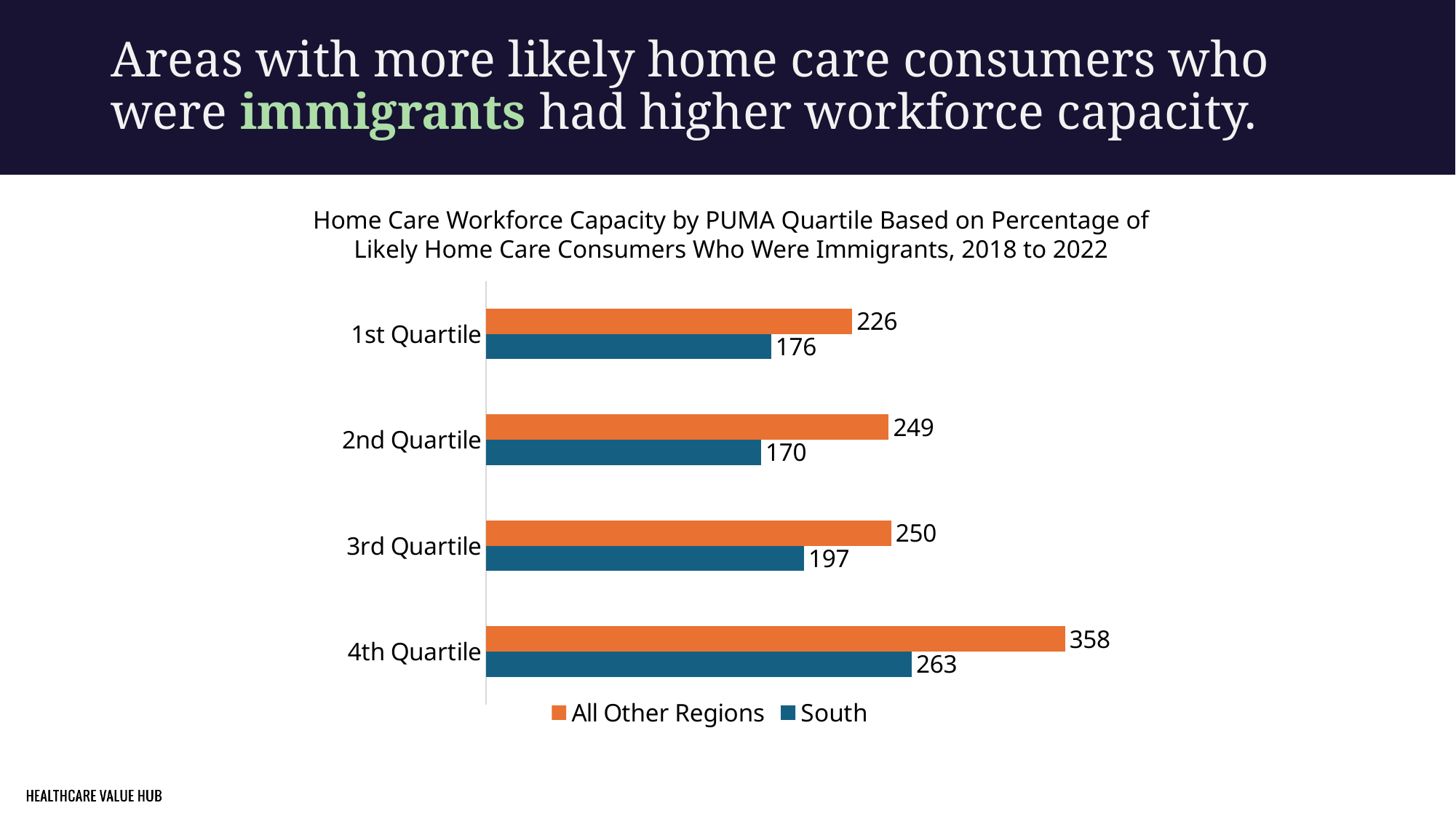
What is the difference between All Other Regions and South in the 4th Quartile? 95 How many quartile categories are shown on the chart? 4 Which is larger in the 1st Quartile, All Other Regions or South? All Other Regions What kind of chart is shown on the slide? Bar chart What is the value for South in the 2nd Quartile? 170 How many series does the legend list? 2 Which quartile has the lowest value for All Other Regions? 1st Quartile Which quartile has the highest value for South? 4th Quartile What is the value for South in the 1st Quartile? 176 What is the value for All Other Regions in the 4th Quartile? 358 What is the difference between All Other Regions and South in the 3rd Quartile? 53 Which quartile has the lowest value for South? 2nd Quartile